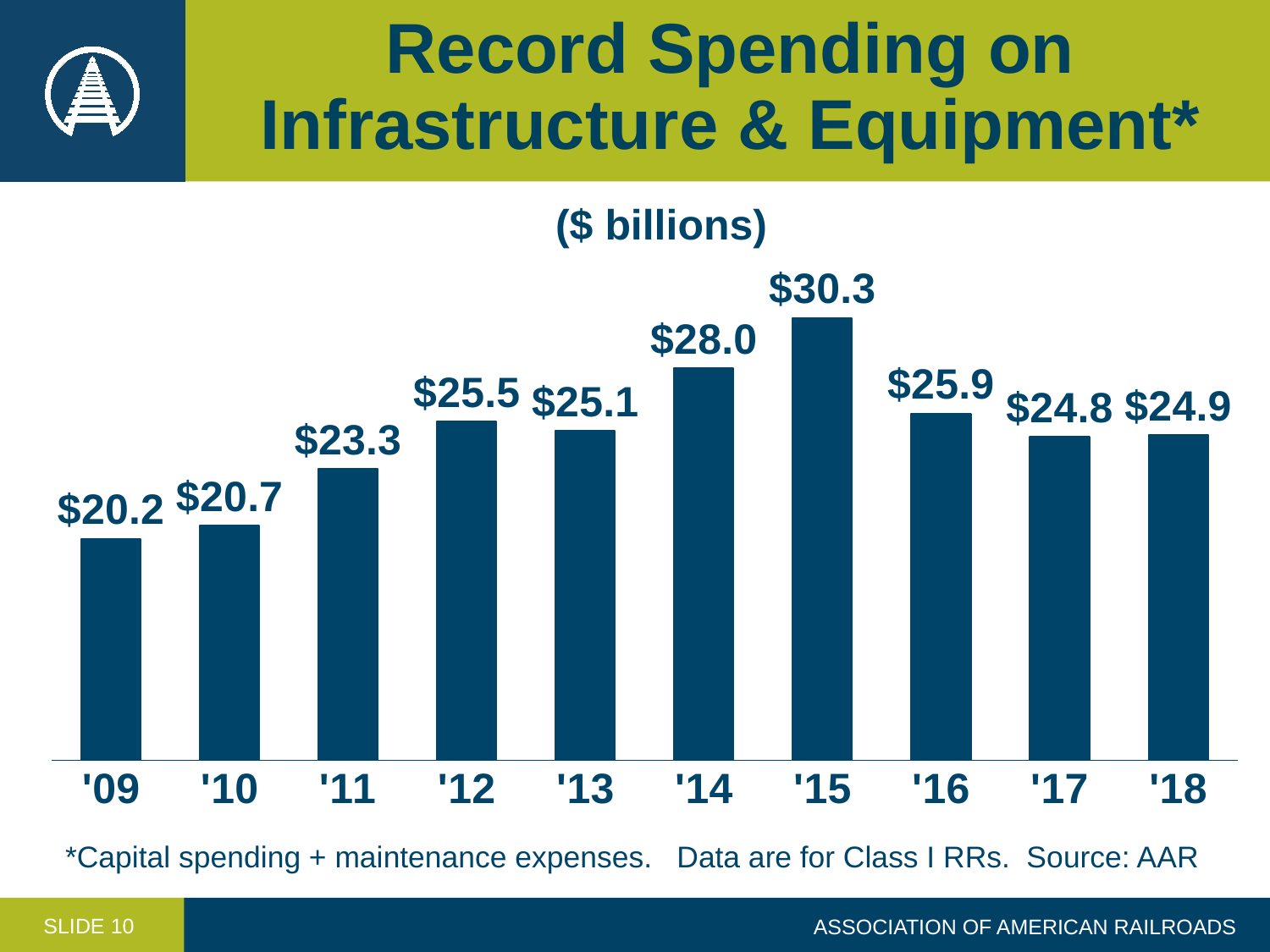
What kind of chart is shown on the slide? Bar chart Which year had the lowest spending? '09 What is the difference in spending between '18 and '09? $4.7 What was the spending on infrastructure and equipment in '15? $30.3 Which year had the highest spending? '15 How many years are shown on the chart? 10 What is the difference in spending between '15 and '14? $2.3 Which year had higher spending, '12 or '13? '12 What was the spending on infrastructure and equipment in '09? $20.2 Which year had higher spending, '16 or '17? '16 What was the spending on infrastructure and equipment in '18? $24.9 In what units are the values on the chart expressed? $ billions